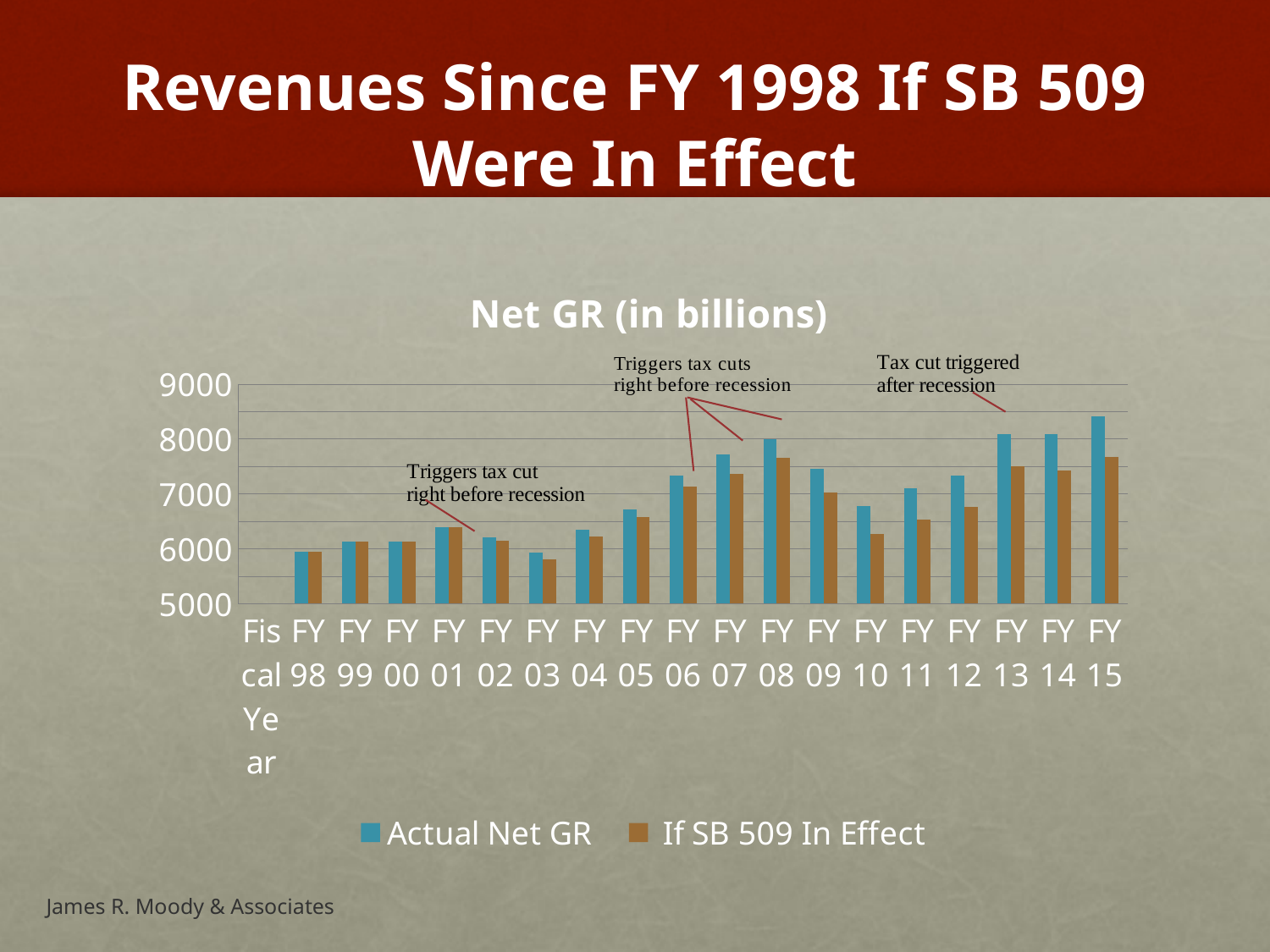
What kind of chart is shown on the slide? bar chart What are the two series named in the legend? Actual Net GR and If SB 509 In Effect Is the If SB 509 In Effect value for FY 03 greater or less than 6000? less How many fiscal years are plotted on the x axis? 18 Is the If SB 509 In Effect value for FY 10 greater or less than 7000? less What is the title of the chart? Net GR (in billions) For FY 13, which is larger: Actual Net GR or If SB 509 In Effect? Actual Net GR Do the Actual Net GR values generally rise or fall from FY 10 to FY 15? rise Is the Actual Net GR value for FY 08 greater or less than 7000? greater Which fiscal year has the highest Actual Net GR value? FY 15 How many series does the legend list? 2